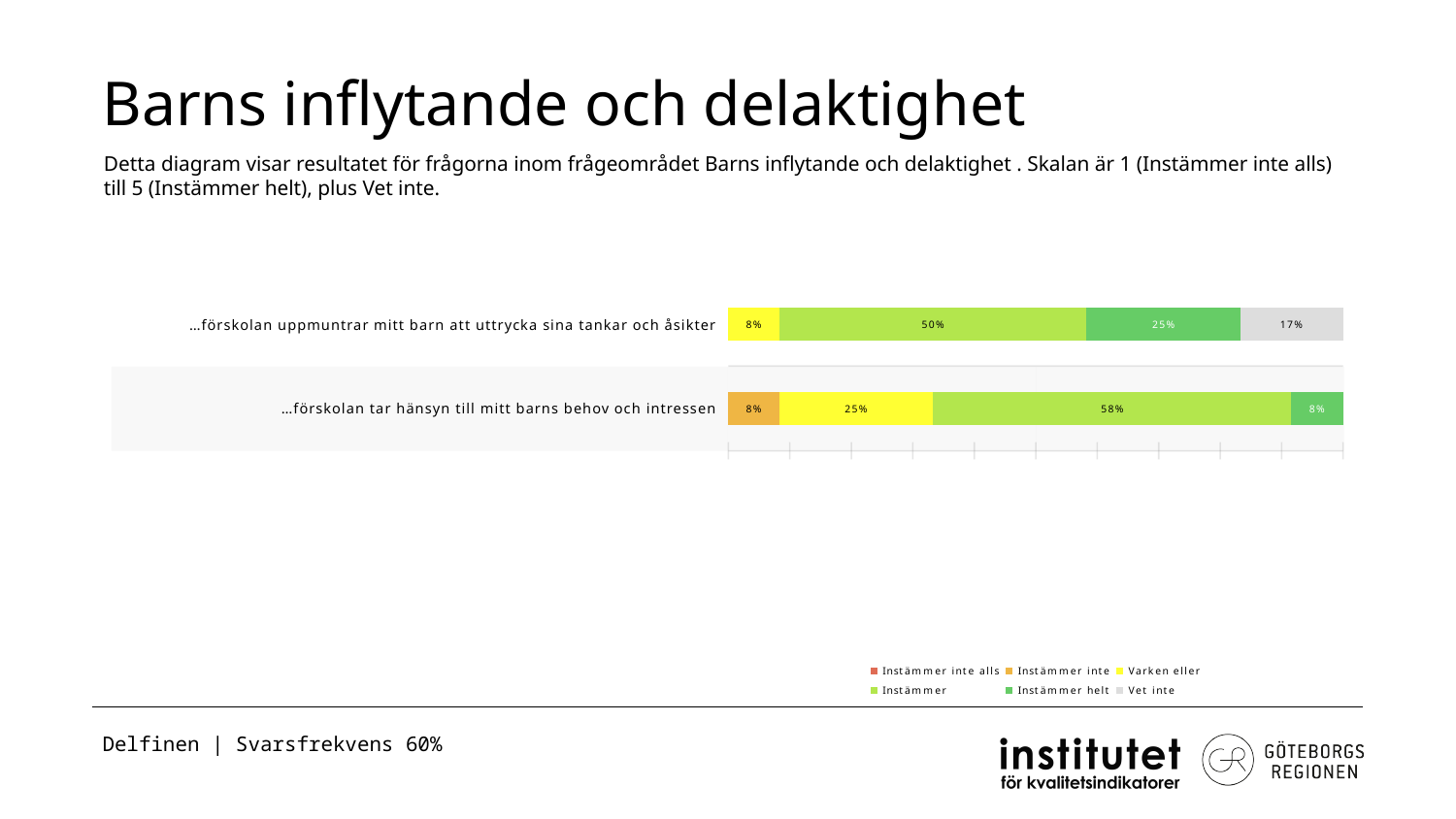
What is the 'Varken eller' share for '…förskolan tar hänsyn till mitt barns behov och intressen'? 25% What kind of chart is shown on the slide? Stacked bar chart What is the 'Instämmer helt' share for '…förskolan uppmuntrar mitt barn att uttrycka sina tankar och åsikter'? 25% How many series does the legend list? 6 What is the total of the labelled segments for '…förskolan uppmuntrar mitt barn att uttrycka sina tankar och åsikter'? 100% What is the 'Instämmer' share for '…förskolan uppmuntrar mitt barn att uttrycka sina tankar och åsikter'? 50% What is the 'Vet inte' share for '…förskolan uppmuntrar mitt barn att uttrycka sina tankar och åsikter'? 17% Which statement has the larger 'Instämmer' share? …förskolan tar hänsyn till mitt barns behov och intressen What is the title of the slide containing the chart? Barns inflytande och delaktighet What is the difference between the 'Instämmer helt' shares of the two statements? 17% How many categories (statements) are plotted in the chart? 2 What is the 'Instämmer' share for '…förskolan tar hänsyn till mitt barns behov och intressen'? 58%